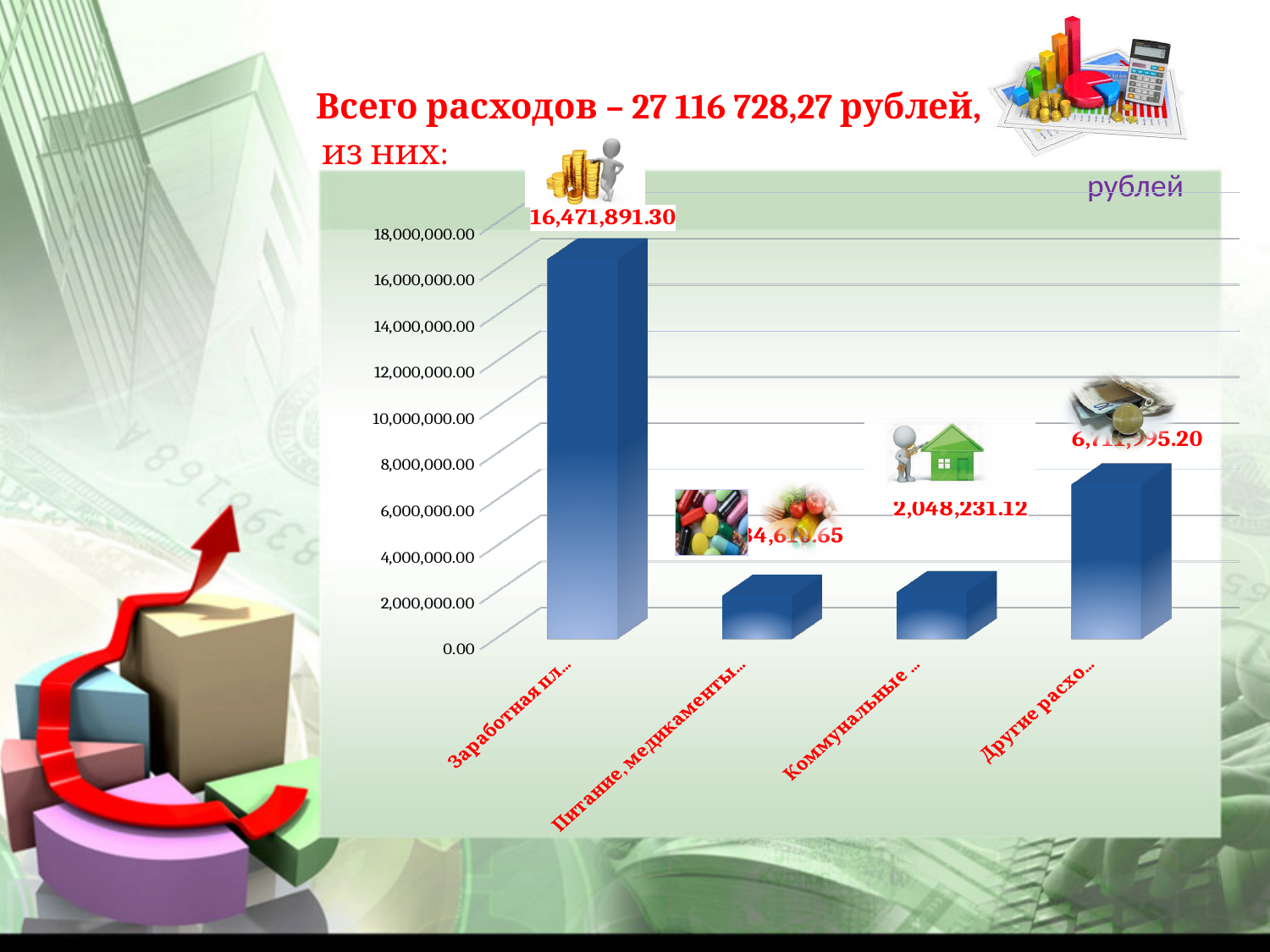
Which category has the highest bar? Заработная пл... Is the value for "Питание, медикаменты..." greater or less than 4,000,000.00? less What is the difference between the "Заработная пл..." value and the "Коммунальные ..." value? 14,423,660.18 Which is larger, the value for "Другие расхо..." or the value for "Коммунальные ..."? Другие расхо... Is the value for "Другие расхо..." greater or less than 6,000,000.00? greater What is the value shown for the "Коммунальные ..." bar? 2,048,231.12 What kind of chart is shown on the slide? bar chart How many categories are plotted in the chart? 4 Which is larger, the value for "Заработная пл..." or the value for "Другие расхо..."? Заработная пл... What is the value shown for the "Заработная пл..." bar? 16,471,891.30 Is the value for "Заработная пл..." greater or less than 14,000,000.00? greater What total expenditure amount is stated in the slide title? 27 116 728,27 рублей